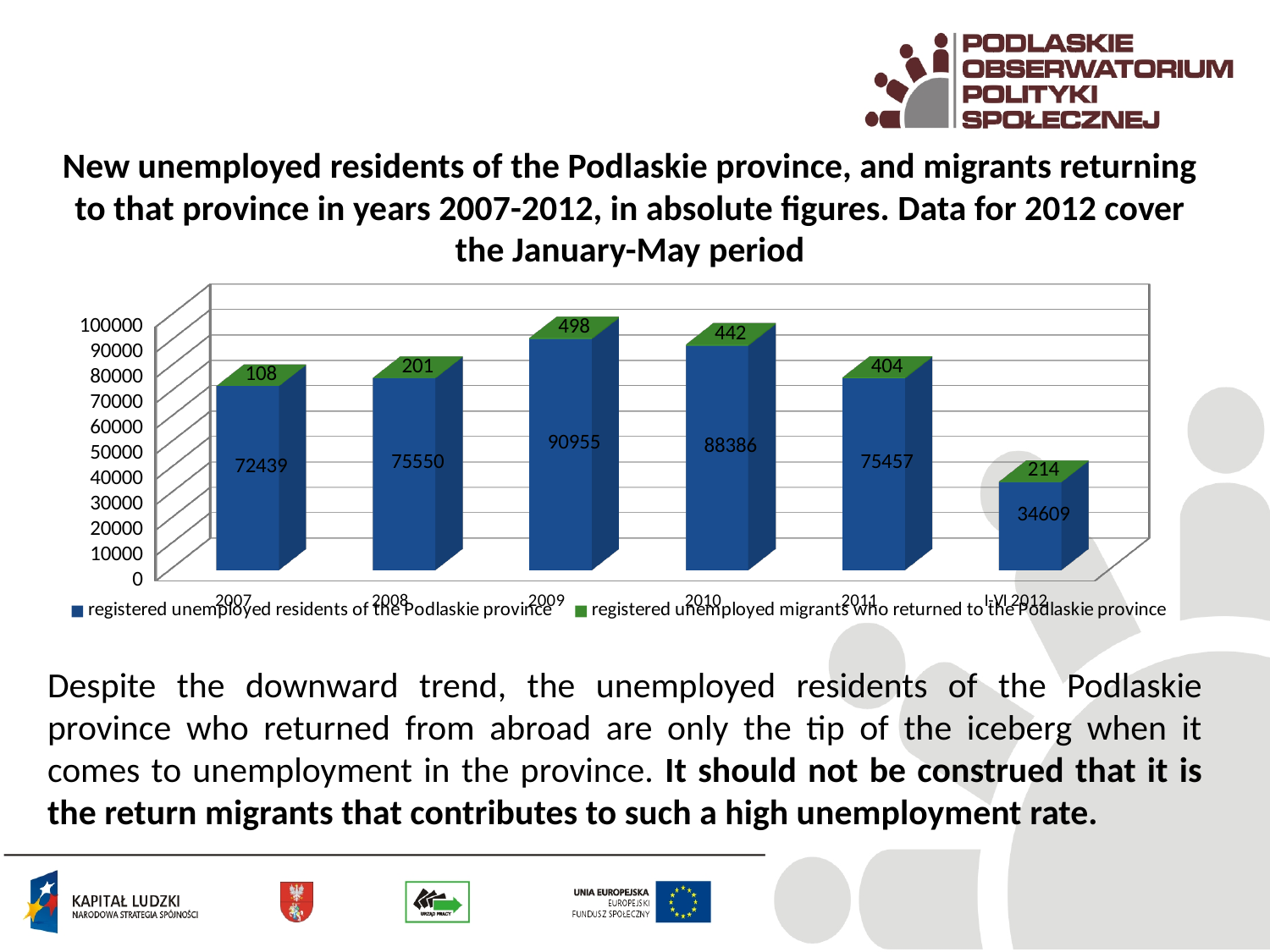
How many series does the legend list? 2 What is the number of registered unemployed residents of the Podlaskie province in 2009? 90955 How many time periods are shown on the x axis? 6 In which year is the number of registered unemployed residents of the Podlaskie province highest? 2009 What is the total of the stacked bar for 2007? 72547 What is the difference between the number of registered unemployed residents in 2009 and in 2010? 2569 What kind of chart is shown on the slide? Stacked bar chart Which is larger: the number of registered unemployed migrants who returned in 2008 or in 2011? 2011 What is the number of registered unemployed migrants who returned to the Podlaskie province in 2010? 442 What is the number of registered unemployed residents of the Podlaskie province for I-VI 2012? 34609 Is the total height of the bar for 2011 greater or less than 70000? greater In which period is the number of registered unemployed migrants who returned to the Podlaskie province lowest? 2007